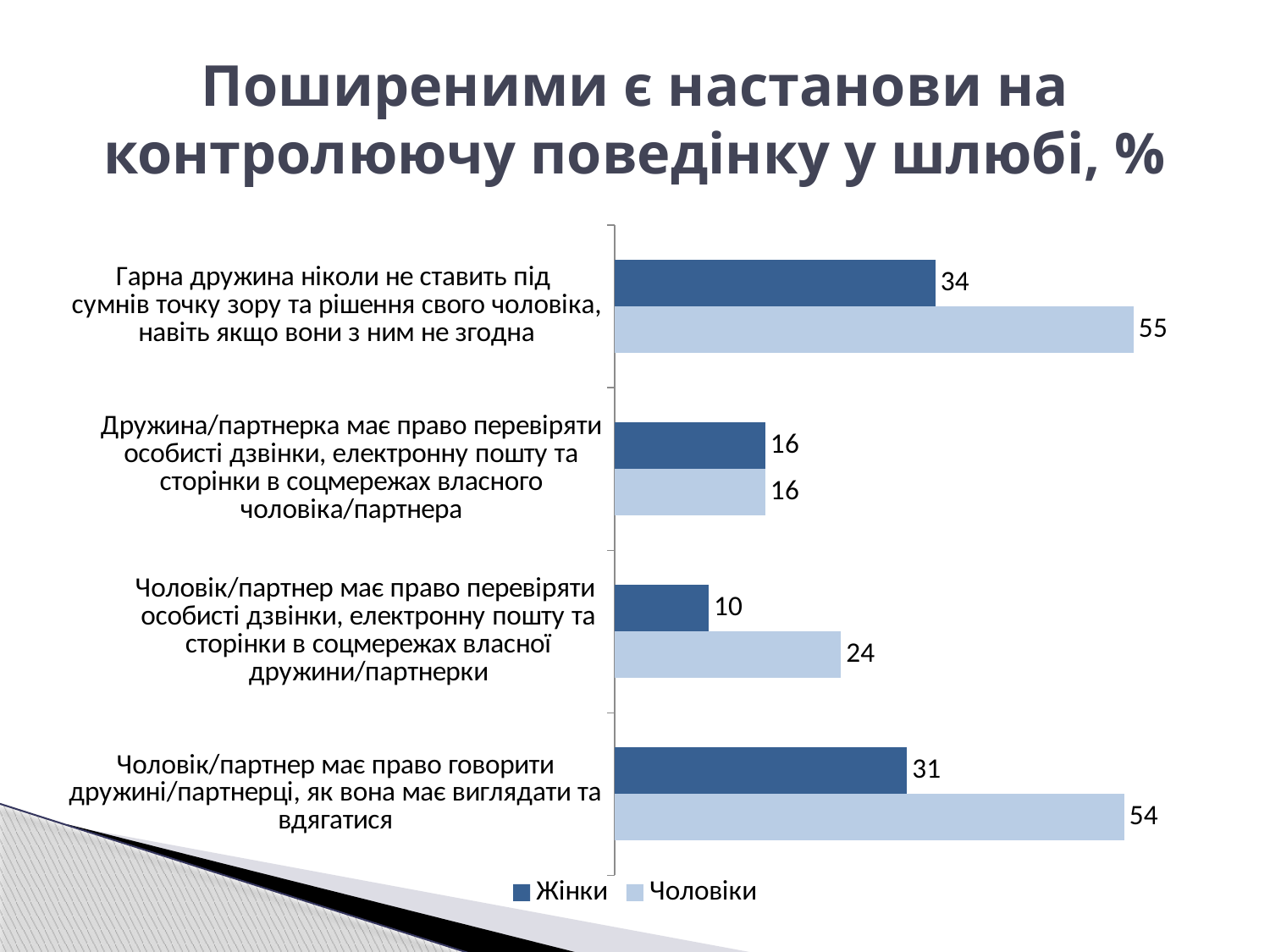
What value is shown for Чоловіки on the statement "Чоловік/партнер має право перевіряти особисті дзвінки, електронну пошту та сторінки в соцмережах власної дружини/партнерки"? 24 What value is shown for Жінки on the statement "Дружина/партнерка має право перевіряти особисті дзвінки, електронну пошту та сторінки в соцмережах власного чоловіка/партнера"? 16 How many series does the legend list? 2 What type of chart is shown on the slide? Bar chart How many statements (categories) are shown in the chart? 4 What value is shown for Чоловіки on the statement "Чоловік/партнер має право говорити дружині/партнерці, як вона має виглядати та вдягатися"? 54 Which statement has the lowest value for Жінки? Чоловік/партнер має право перевіряти особисті дзвінки, електронну пошту та сторінки в соцмережах власної дружини/партнерки What is the difference between the Чоловіки and Жінки values for the statement "Чоловік/партнер має право говорити дружині/партнерці, як вона має виглядати та вдягатися"? 23 What value is shown for Жінки on the statement "Гарна дружина ніколи не ставить під сумнів точку зору та рішення свого чоловіка, навіть якщо вони з ним не згодна"? 34 What is the difference between the Чоловіки and Жінки values for the statement "Гарна дружина ніколи не ставить під сумнів точку зору та рішення свого чоловіка, навіть якщо вони з ним не згодна"? 21 For the statement "Чоловік/партнер має право перевіряти особисті дзвінки, електронну пошту та сторінки в соцмережах власної дружини/партнерки", which series has the larger value, Жінки or Чоловіки? Чоловіки Which statement has the highest value for Чоловіки? Гарна дружина ніколи не ставить під сумнів точку зору та рішення свого чоловіка, навіть якщо вони з ним не згодна